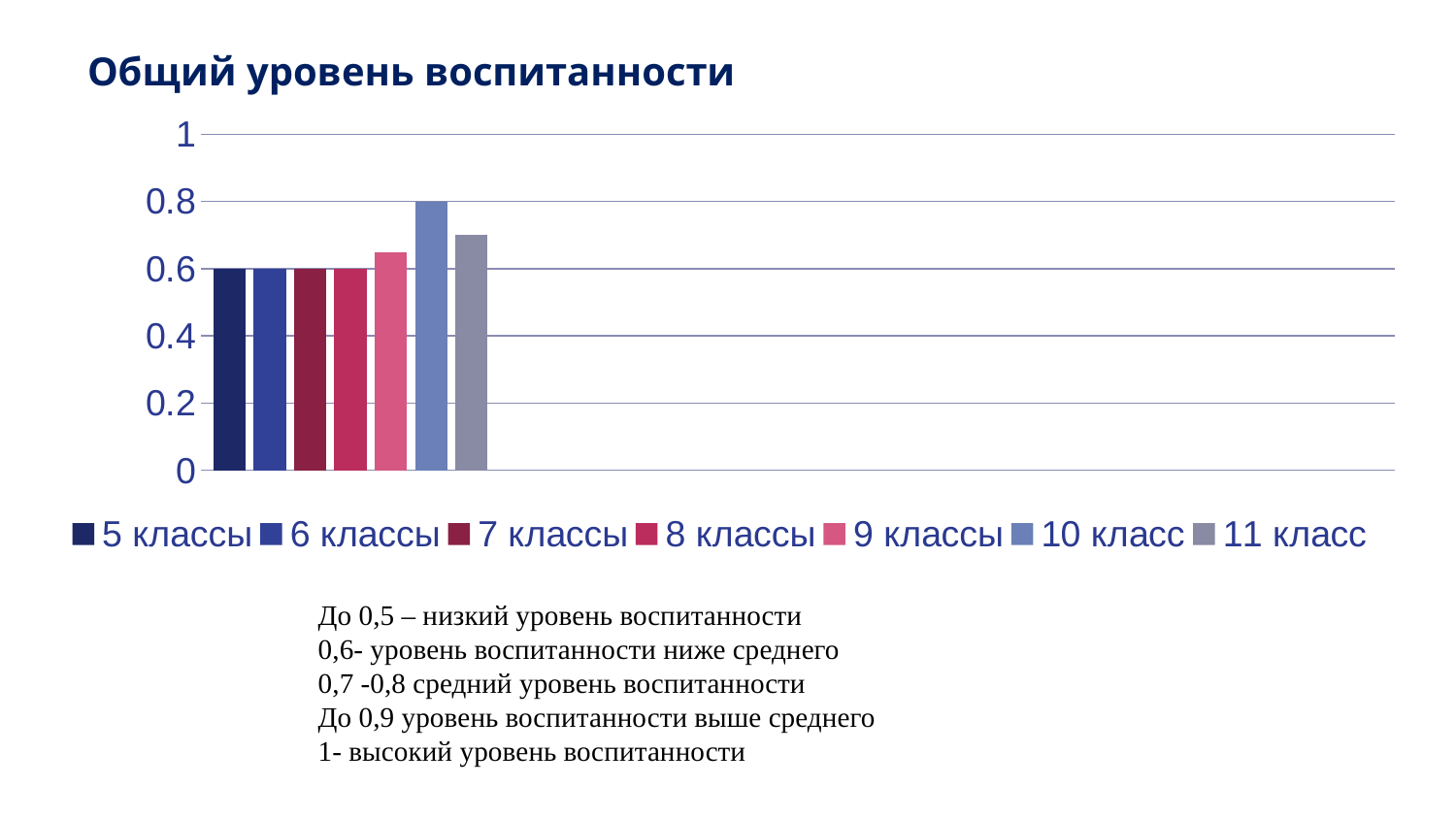
What is the difference between the value for 10 класс and the value for 5 классы? 0.2 Which legend entry is shown last in the legend? 11 класс Which is larger, the value for 10 класс or the value for 11 класс? 10 класс How many bars are plotted in the chart? 7 What is the value for 5 классы? 0.6 Is the value for 9 классы greater or less than 0.6? greater What type of chart is shown on the slide? Bar chart What is the title of the chart? Общий уровень воспитанности What is the value for 10 класс? 0.8 How many series does the legend list? 7 Which series has the highest value? 10 класс Is the value for 11 класс greater or less than 0.8? less